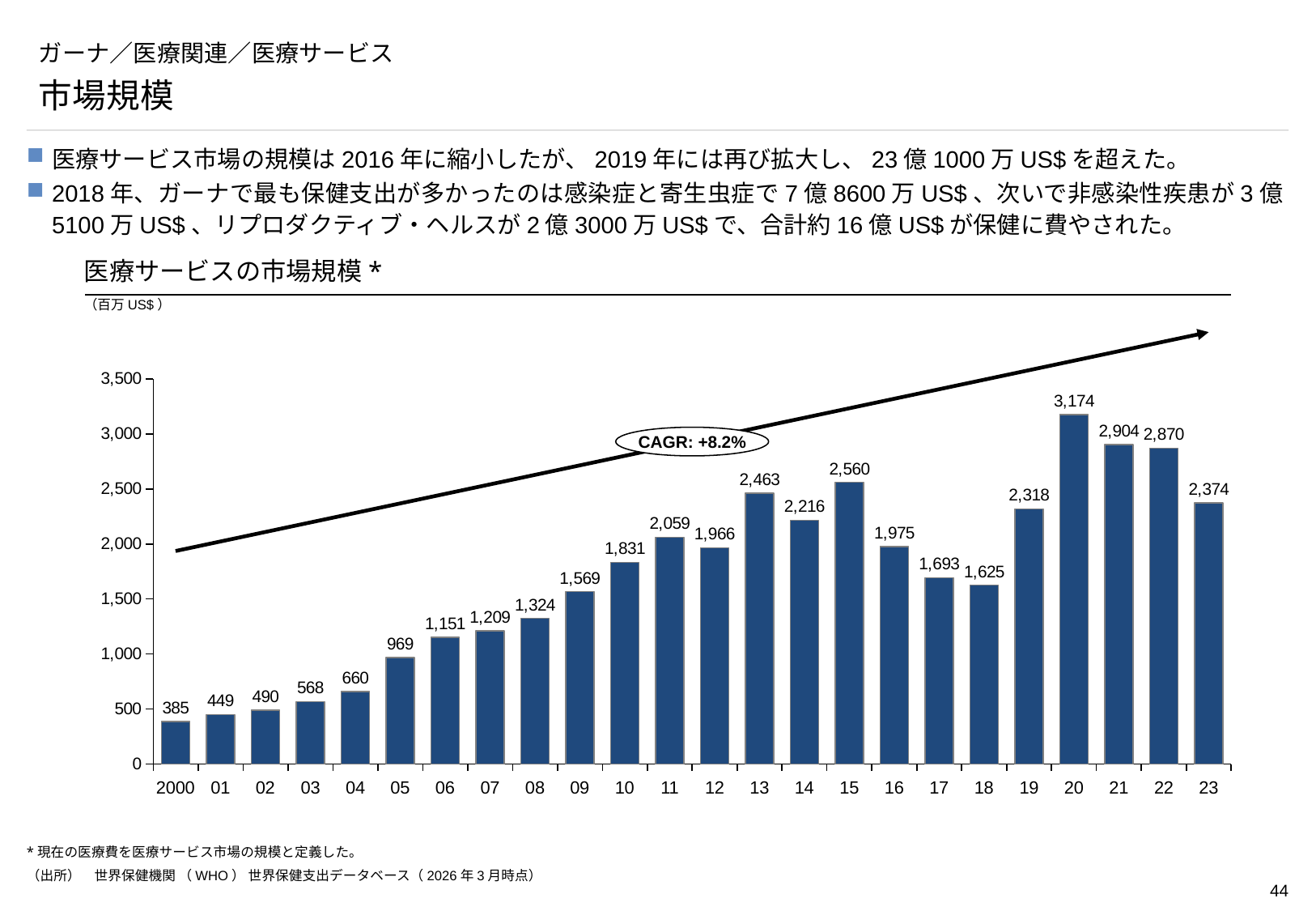
Is the value for 2013 greater or less than 2,000? greater Do the values generally rise or fall from 2000 to 2015? rise Which year has the lowest value? 2000 What is the difference between the values for 2020 and 2023? 800 What is the value for 2020? 3,174 What kind of chart is this? bar chart What CAGR is shown on the chart? +8.2% What is the value for 2000? 385 Which year has the highest value? 2020 What is the value for 2016? 1,975 Which is larger, the value for 2015 or the value for 2019? 2015 How many years are shown on the x axis? 24